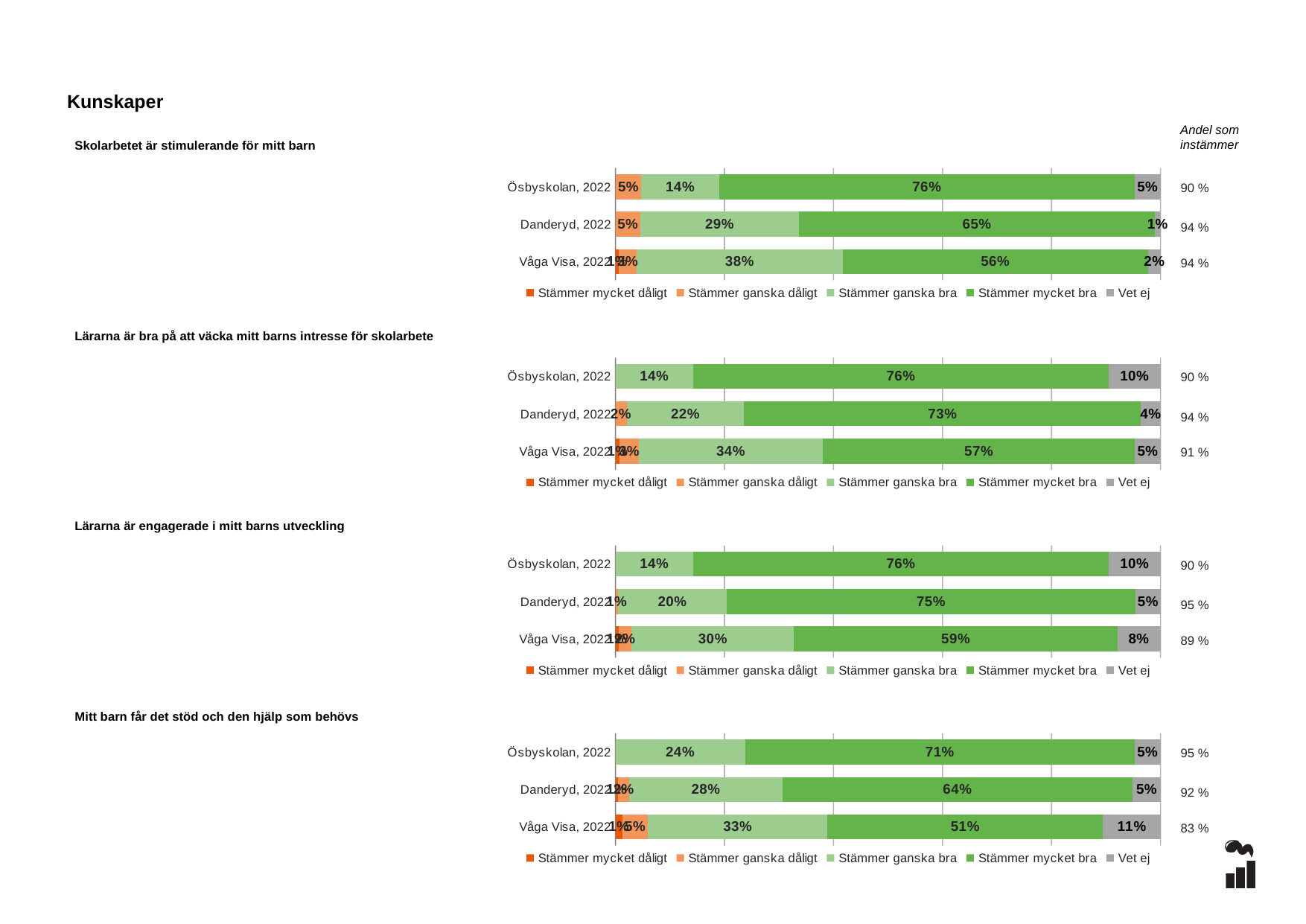
In the chart 'Mitt barn får det stöd och den hjälp som behövs', which row has the lowest 'Andel som instämmer'? Våga Visa, 2022 In the chart 'Mitt barn får det stöd och den hjälp som behövs', what is the 'Stämmer ganska bra' value for Ösbyskolan, 2022? 24% How many series does the legend list for the chart 'Skolarbetet är stimulerande för mitt barn'? 5 In the chart 'Skolarbetet är stimulerande för mitt barn', what is the 'Stämmer ganska bra' value for Danderyd, 2022? 29% In the chart 'Mitt barn får det stöd och den hjälp som behövs', what is the 'Vet ej' value for Våga Visa, 2022? 11% In the chart 'Skolarbetet är stimulerande för mitt barn', what percentage of Ösbyskolan, 2022 answered 'Stämmer mycket bra'? 76% In the chart 'Skolarbetet är stimulerande för mitt barn', which row has the highest 'Stämmer ganska bra' value? Våga Visa, 2022 In the chart 'Lärarna är bra på att väcka mitt barns intresse för skolarbete', what is the 'Vet ej' value for Ösbyskolan, 2022? 10% In the chart 'Lärarna är engagerade i mitt barns utveckling', which is larger: the 'Stämmer mycket bra' value for Danderyd, 2022 or for Våga Visa, 2022? Danderyd, 2022 In the chart 'Lärarna är engagerade i mitt barns utveckling', what is the 'Andel som instämmer' for Danderyd, 2022? 95 % What kind of chart is used for 'Lärarna är engagerade i mitt barns utveckling'? Stacked bar chart In the chart 'Lärarna är bra på att väcka mitt barns intresse för skolarbete', what is the difference between the 'Stämmer mycket bra' values for Ösbyskolan, 2022 and Danderyd, 2022? 3%